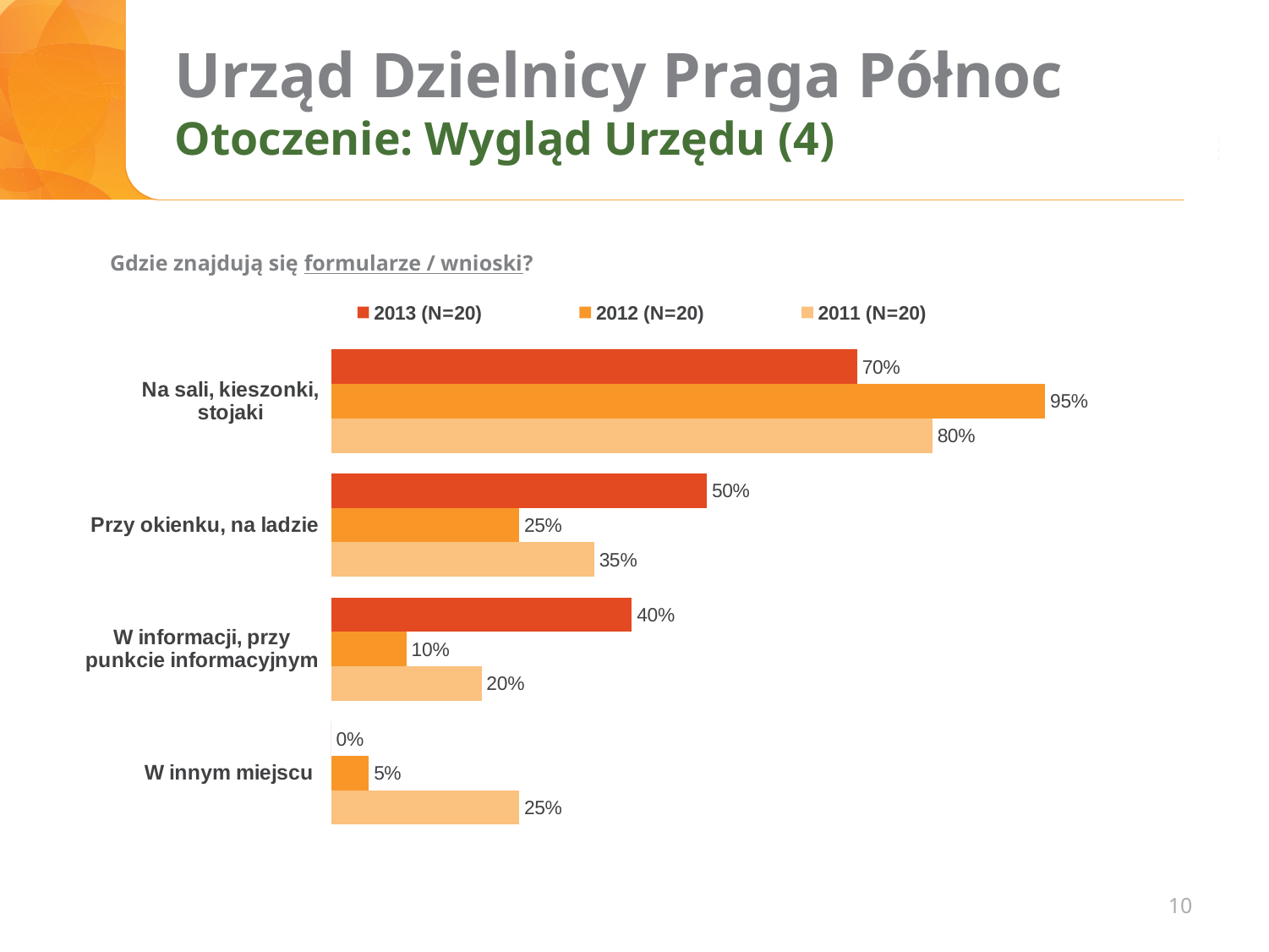
What question does the chart answer, according to the text above it? Gdzie znajdują się formularze / wnioski? How many series does the legend list? 3 What is the 2013 (N=20) value for "Na sali, kieszonki, stojaki"? 70% Which is larger for "Przy okienku, na ladzie": the 2013 (N=20) value or the 2011 (N=20) value? 2013 (N=20) What is the difference between the 2012 (N=20) and 2013 (N=20) values for "Na sali, kieszonki, stojaki"? 25% What is the 2012 (N=20) value for "W informacji, przy punkcie informacyjnym"? 10% Which category has the highest 2012 (N=20) value? Na sali, kieszonki, stojaki What is the 2011 (N=20) value for "W innym miejscu"? 25% What kind of chart is shown on the slide? Bar chart Which category has the lowest 2013 (N=20) value? W innym miejscu How many categories are shown on the chart? 4 What is the 2012 (N=20) value for "Przy okienku, na ladzie"? 25%